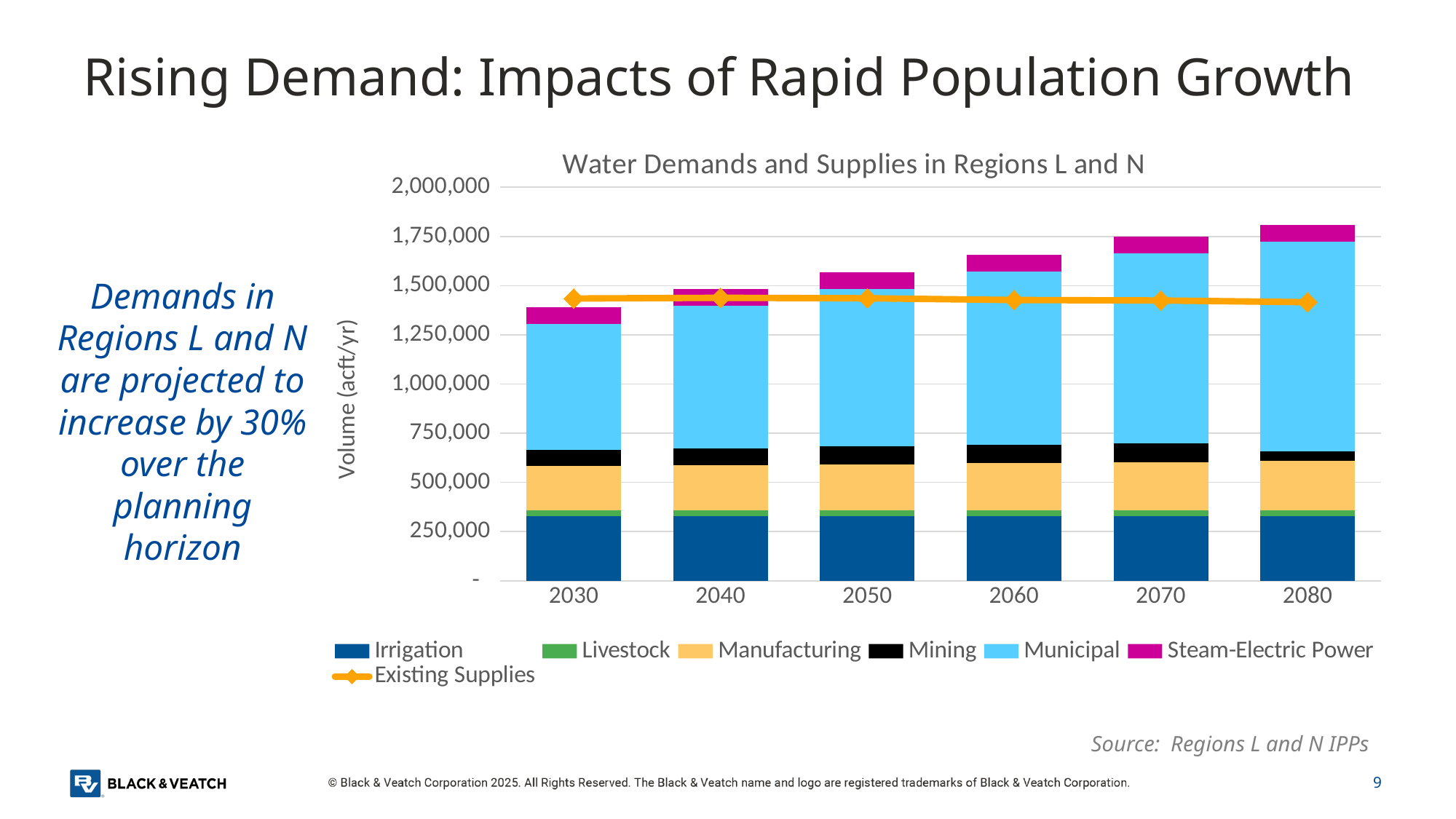
Is the Existing Supplies value in 2030 greater or less than 1,500,000? less How many years are shown along the x axis of the chart? 6 How many series does the chart legend list? 7 What is the title of the chart? Water Demands and Supplies in Regions L and N In 2080, which is larger: the total demand bar or the Existing Supplies line? The total demand bar What kind of chart is shown on the slide? Stacked bar chart with a line Which year has the lowest total demand bar? 2030 Is the total demand bar for 2030 greater or less than 1,500,000? less Do the total demand bars rise or fall from 2030 to 2080? Rise Is the total demand bar for 2060 greater or less than 1,500,000? greater Which year has the highest total demand bar? 2080